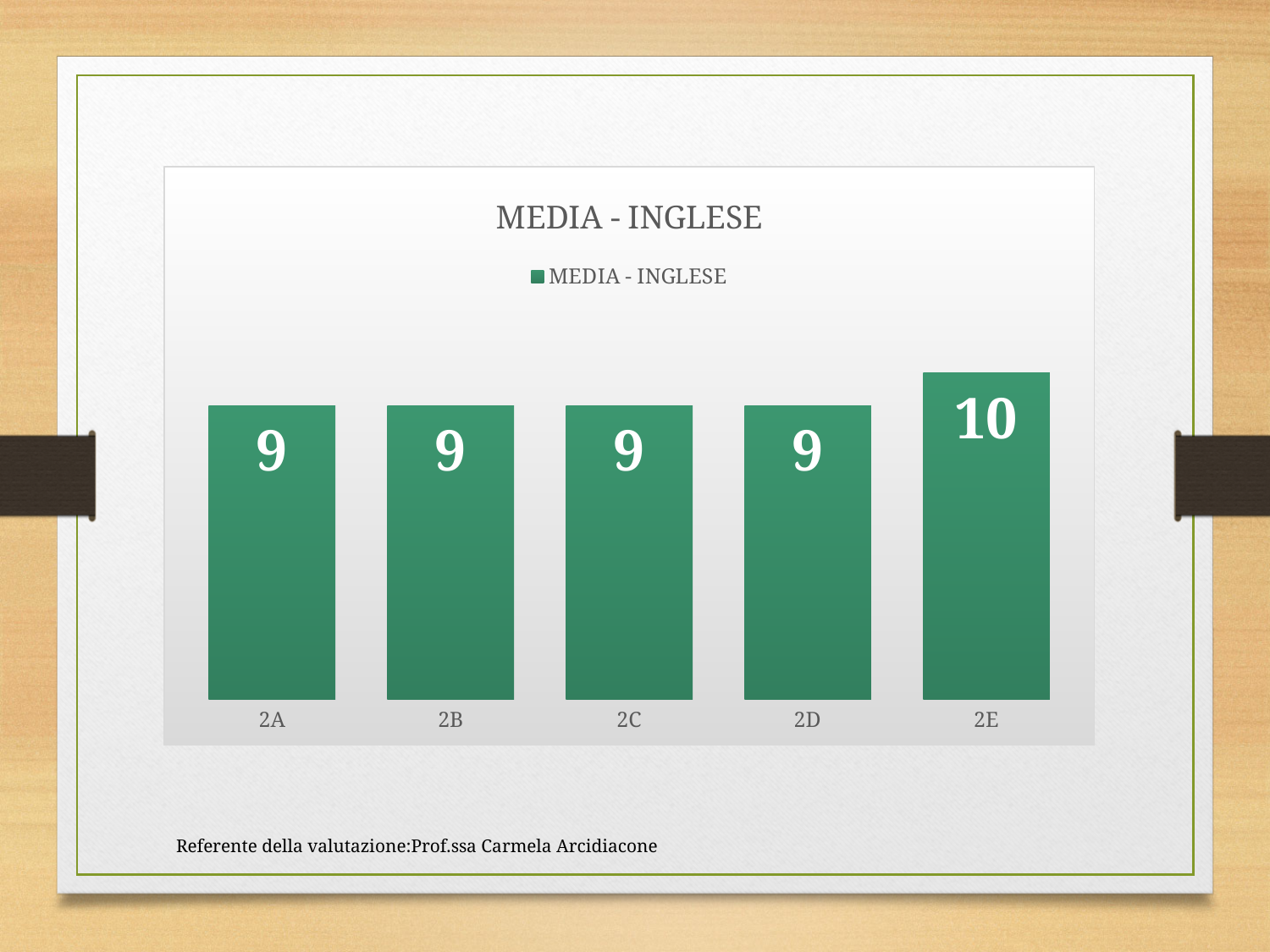
What kind of chart is shown? bar chart Which is larger, the value for 2E or the value for 2B? 2E What is the difference between the values for 2E and 2D? 1 What is the value for 2E? 10 What is the value for 2C? 9 What colour are the bars? green How many categories have a value of 9? 4 Which category has the highest value? 2E How many series does the legend list? 1 What is the value for 2A? 9 What is the title of the chart? MEDIA - INGLESE How many categories are shown on the x axis? 5